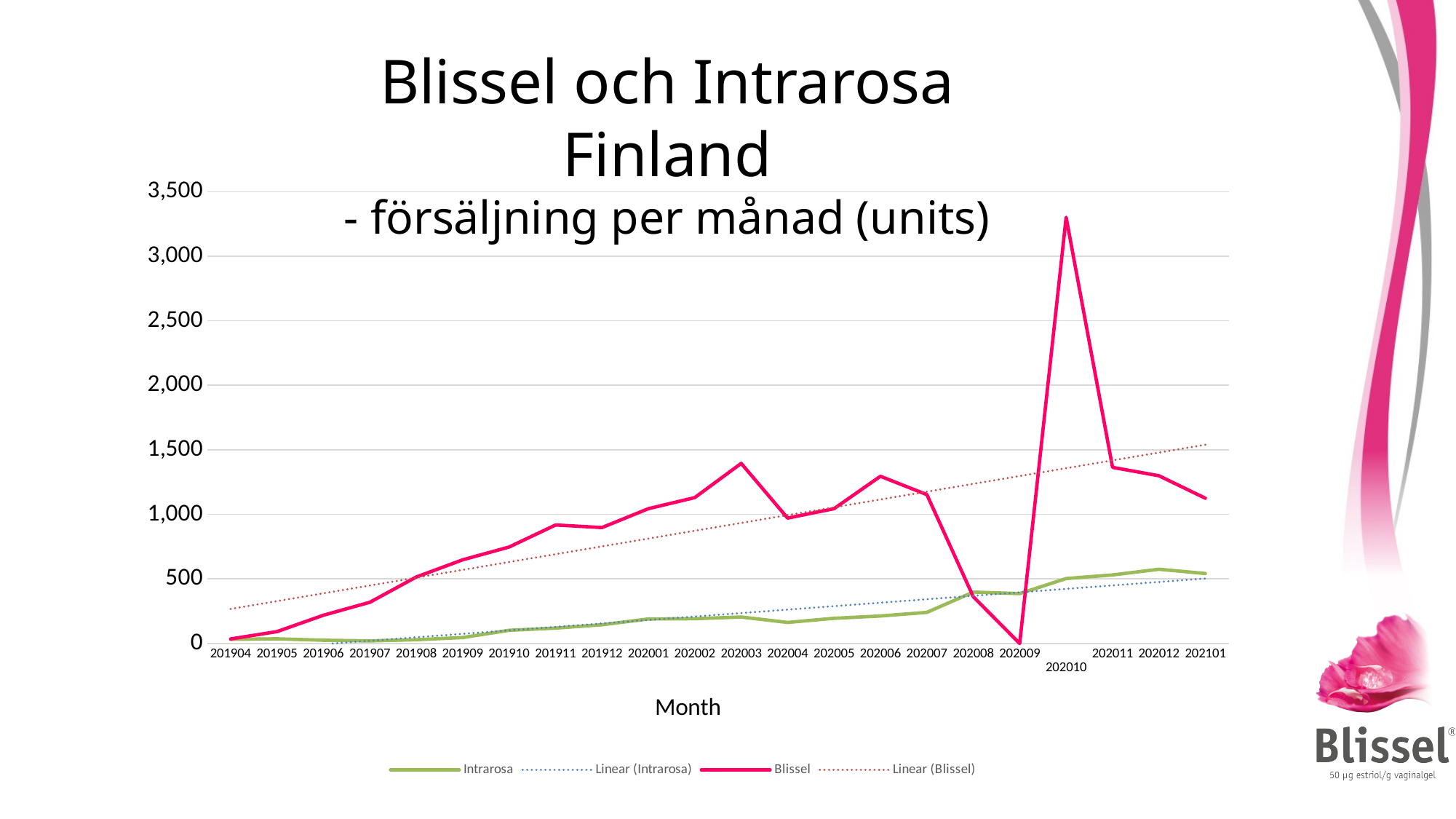
Does the Intrarosa line generally rise or fall from 201904 to 202101? rise Is the value for Blissel in 202009 greater or less than 500? less Which series has the larger value in 202003, Blissel or Intrarosa? Blissel How many entries does the chart legend list? 4 What kind of chart is shown on the slide? line chart Is the value for Blissel in 202003 greater or less than 1,000? greater Which series has the larger value in 202009, Blissel or Intrarosa? Intrarosa Is the value for Intrarosa in 202004 greater or less than 500? less How many months are plotted along the x axis? 22 What is the label of the x axis? Month In which month does the Blissel line reach its highest value? 202010